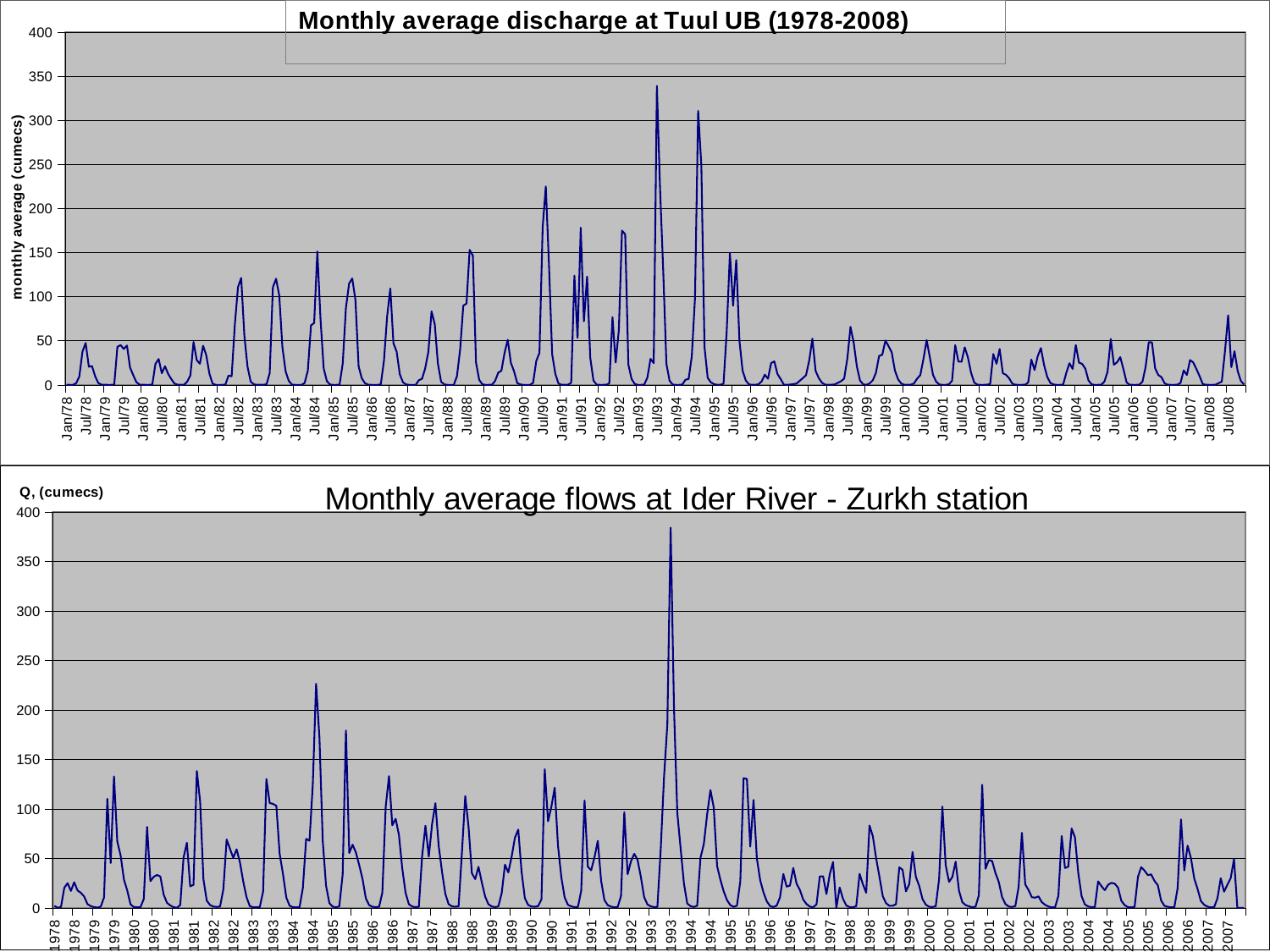
What kind of chart is the bottom chart, 'Monthly average flows at Ider River - Zurkh station'? line chart In the bottom chart (Ider River - Zurkh station), is the peak value in 1993 greater or less than 350? greater In the bottom chart (Ider River - Zurkh station), is the peak value in 1985 greater or less than 200? less In the top chart (Tuul UB), is the peak value in 1990 greater or less than 200? greater In the top chart (Tuul UB), which is larger: the peak in 1993 or the peak in 1994? 1993 In the bottom chart (Ider River - Zurkh station), in which year does the highest peak occur? 1993 What kind of chart is the top chart, 'Monthly average discharge at Tuul UB (1978-2008)'? line chart What is the title of the top chart? Monthly average discharge at Tuul UB (1978-2008) In the bottom chart (Ider River - Zurkh station), which is larger: the peak in 1984 or the peak in 1985? 1984 In the top chart (Tuul UB), in which year does the highest peak occur? 1993 What is the y-axis label of the top chart? monthly average (cumecs)